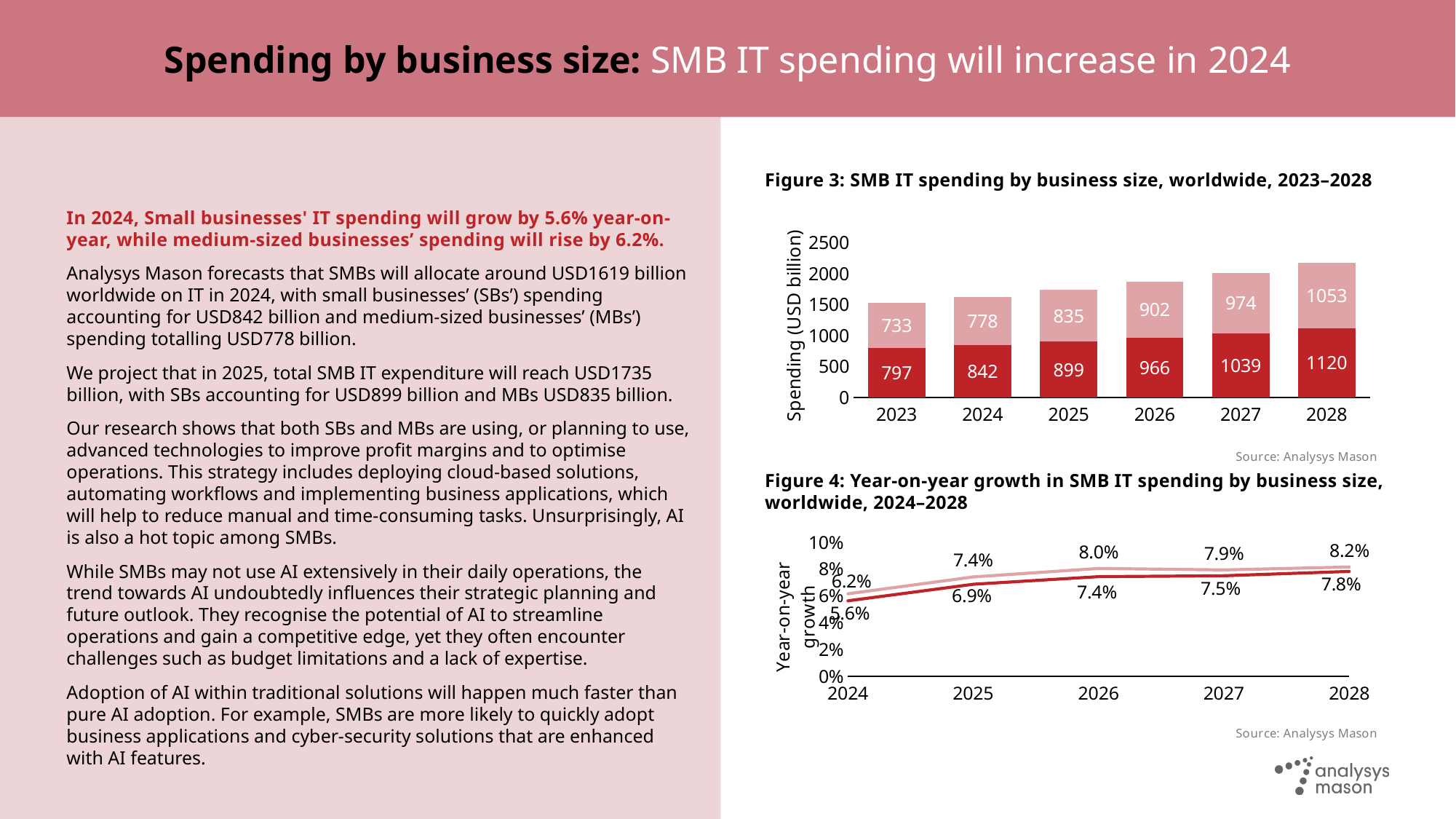
In Figure 4, what is the value of the lower (darker red) line in 2024? 5.6% In Figure 3, what is the total of the stacked bar for 2023? 1530 What kind of chart is Figure 3: SMB IT spending by business size, worldwide, 2023–2028? Bar chart In Figure 4, what is the value of the upper (lighter pink) line in 2026? 8.0% In Figure 3, what is the value of the lighter pink top segment for 2027? 974 In Figure 4, which year has the highest value for the lower (darker red) line? 2028 In Figure 3, how many years are shown on the x axis? 6 In Figure 3, what is the difference between the darker red bottom segment in 2028 and in 2023? 323 In Figure 3, which year has the highest value for the darker red bottom segment? 2028 In Figure 3, do the total bar heights rise or fall from 2023 to 2028? Rise In Figure 3, what is the value of the darker red bottom segment for 2026? 966 What kind of chart is Figure 4: Year-on-year growth in SMB IT spending by business size, worldwide, 2024–2028? Line chart